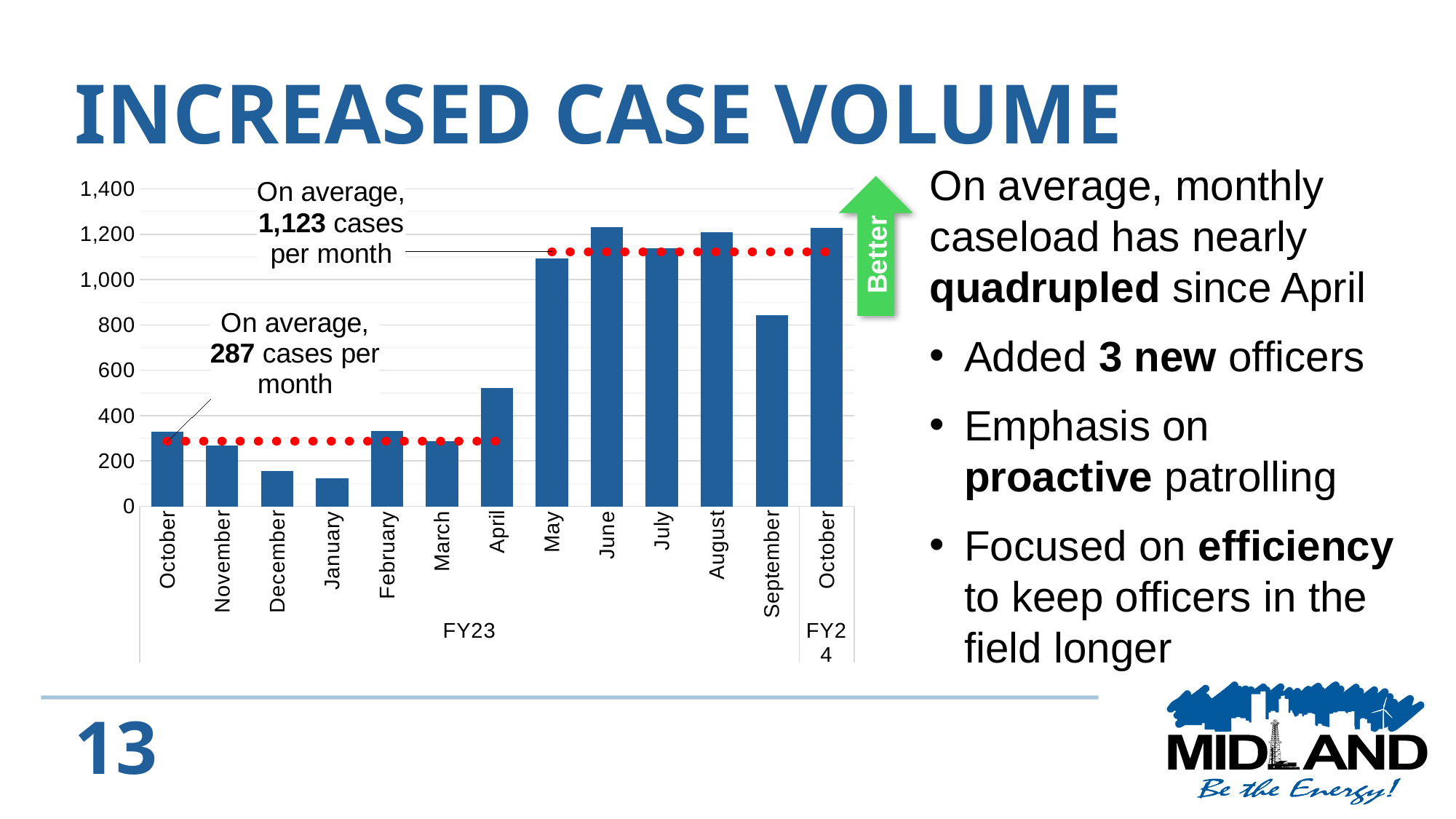
What kind of chart is shown on the slide? bar chart Is the value for April greater or less than 400? greater Which month has the lowest bar in the chart? January According to the chart annotation, what was the average number of cases per month for the later period (May onward)? 1,123 According to the chart annotation, what was the average number of cases per month for the earlier period (October through April)? 287 Is the value for December greater or less than 200? less Which is larger, the value for April or the value for March? April Which is larger, the value for August or the value for September? August Is the value for May greater or less than 1,000? greater Which is larger, the value for May or the value for April? May How many monthly bars are plotted in the chart? 13